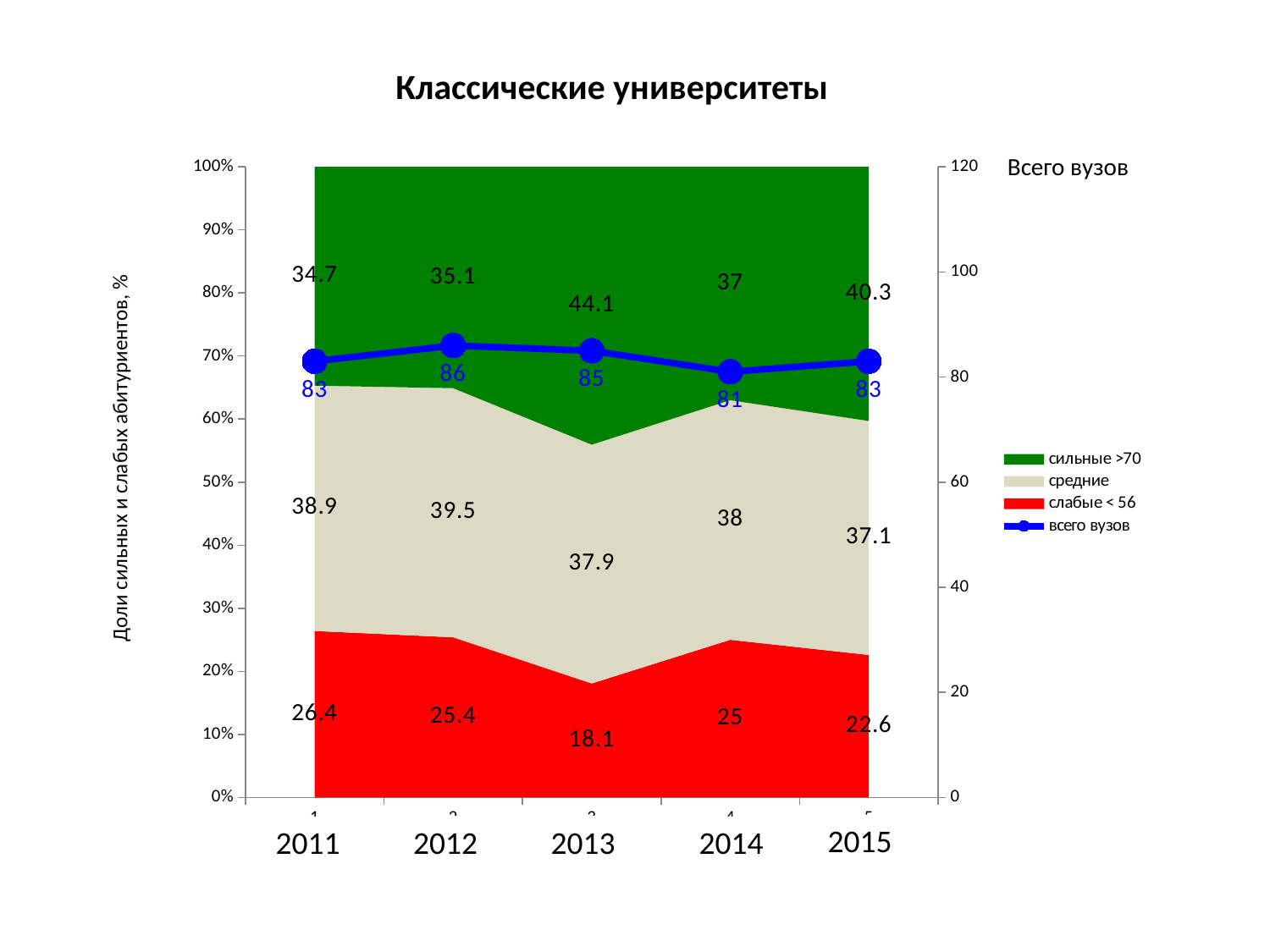
What is the value for 'слабые < 56' in 2011? 26.4 In which year is the 'сильные >70' value highest? 2013 What is the difference between the 'сильные >70' values in 2015 and 2011? 5.6 Which is larger in 2014: the 'средние' value or the 'слабые < 56' value? средние In which year is 'всего вузов' lowest? 2014 In which year is the 'слабые < 56' value lowest? 2013 What is the value for 'средние' in 2015? 37.1 How many series does the legend list? 4 How many years are shown on the x axis? 5 What is the title of the chart? Классические университеты What is the value for 'сильные >70' in 2013? 44.1 What is the value of 'всего вузов' in 2012? 86